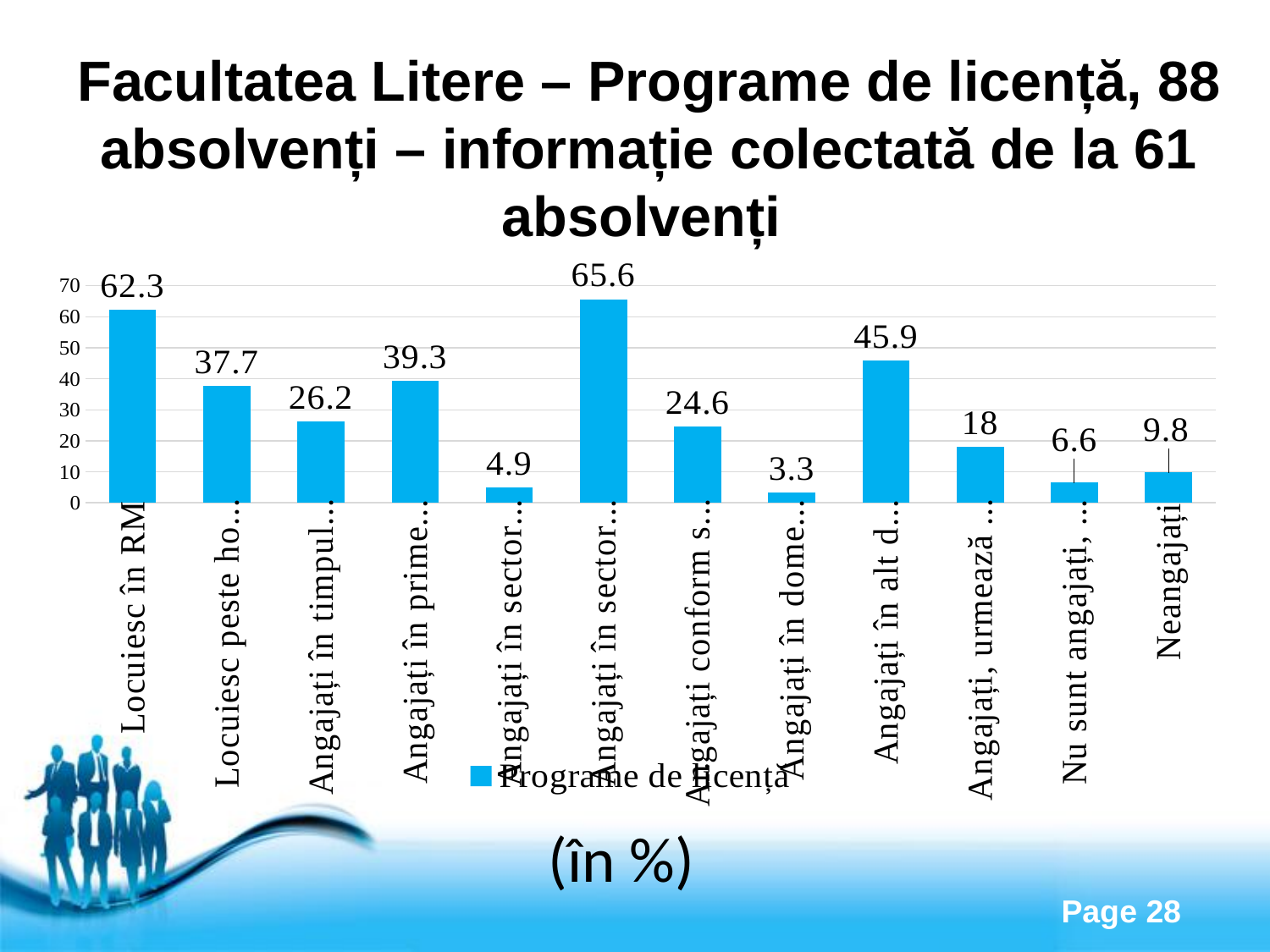
What series name is shown in the chart legend? Programe de licență What is the value for "Neangajați"? 9.8 What is the difference between the values for "Locuiesc în RM" and "Neangajați"? 52.5 What kind of chart is shown on the slide? bar chart How many series does the legend list? 1 How many bars are shown in the chart? 12 Which is larger, the value for "Locuiesc în RM" or the value for "Neangajați"? Locuiesc în RM Is the value for "Neangajați" greater or less than 20? less What is the lowest value shown in the chart? 3.3 In what unit are the chart values expressed, according to the text below the chart? % What is the highest value shown in the chart? 65.6 What is the value for "Locuiesc în RM"? 62.3